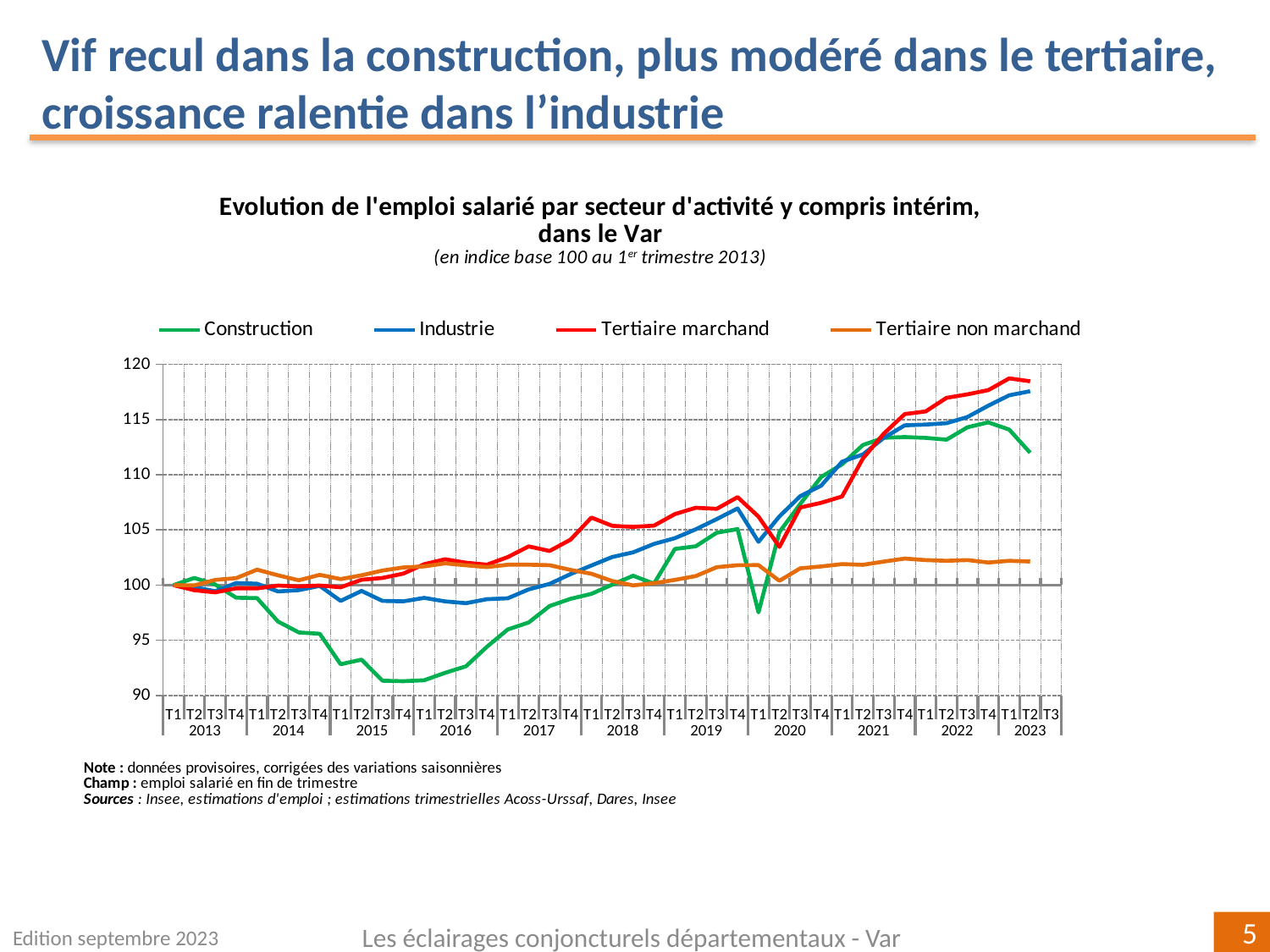
Is the value for Construction at T3 2015 greater or less than 95? less At T1 2020, which is higher: Construction or Industrie? Industrie How many series does the legend list? 4 Is the value for Tertiaire marchand at T2 2023 greater or less than 115? greater What kind of chart is shown on the slide? line chart Is the value for Construction at T1 2020 greater or less than 100? less What is the index value of every series at T1 2013, the base period? 100 Which series is plotted in green? Construction Which series has the lowest value at T3 2015? Construction Which series has the lowest value at T2 2023? Tertiaire non marchand Does the Construction series rise or fall between T4 2022 and T2 2023? fall